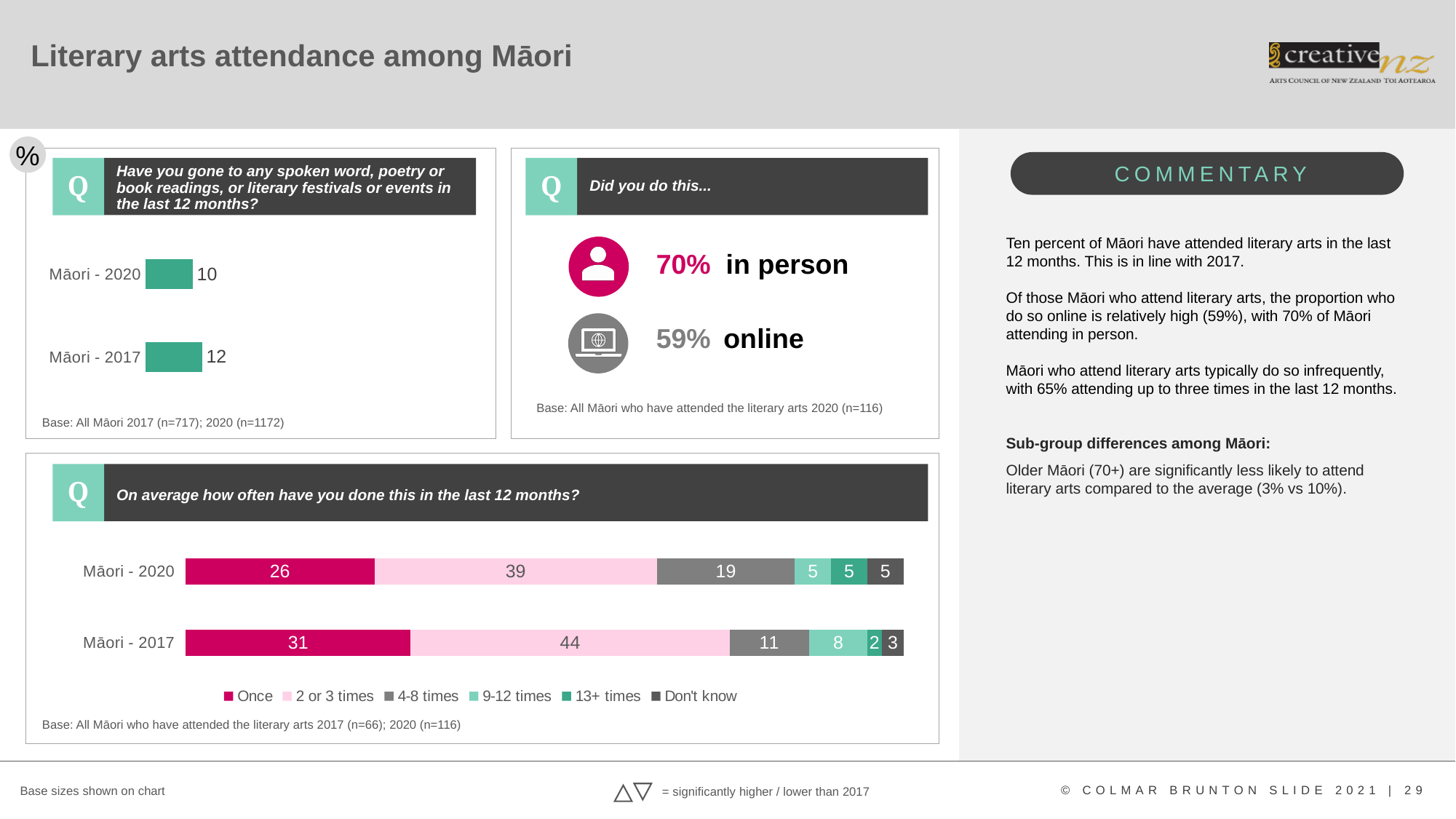
In the bottom chart on how often Māori have attended, what is the value for '2 or 3 times' for Māori - 2017? 44 In the bottom chart on how often Māori have attended, what is the total of the Māori - 2017 stacked bar? 99 In the bottom chart on how often Māori have attended, which category has the largest value for Māori - 2020? 2 or 3 times In the bottom chart on how often Māori have attended, what is the difference between the '4-8 times' values for 2020 and 2017? 8 In the top-left chart on attendance in the last 12 months, what is the difference between the 2017 and 2020 values? 2 In the bottom chart on how often Māori have attended, what is the value for 'Once' for Māori - 2020? 26 In the top-left chart on attendance in the last 12 months, which year has the higher value, 2020 or 2017? Māori - 2017 In the top-left chart on attendance in the last 12 months, what is the value for Māori - 2020? 10 What kind of chart is the bottom chart on how often Māori have attended in the last 12 months? Stacked bar chart In the top-left chart on attendance in the last 12 months, what is the value for Māori - 2017? 12 In the bottom chart on how often Māori have attended, how many series does the legend list? 6 In the bottom chart on how often Māori have attended, what is the value for '4-8 times' for Māori - 2020? 19